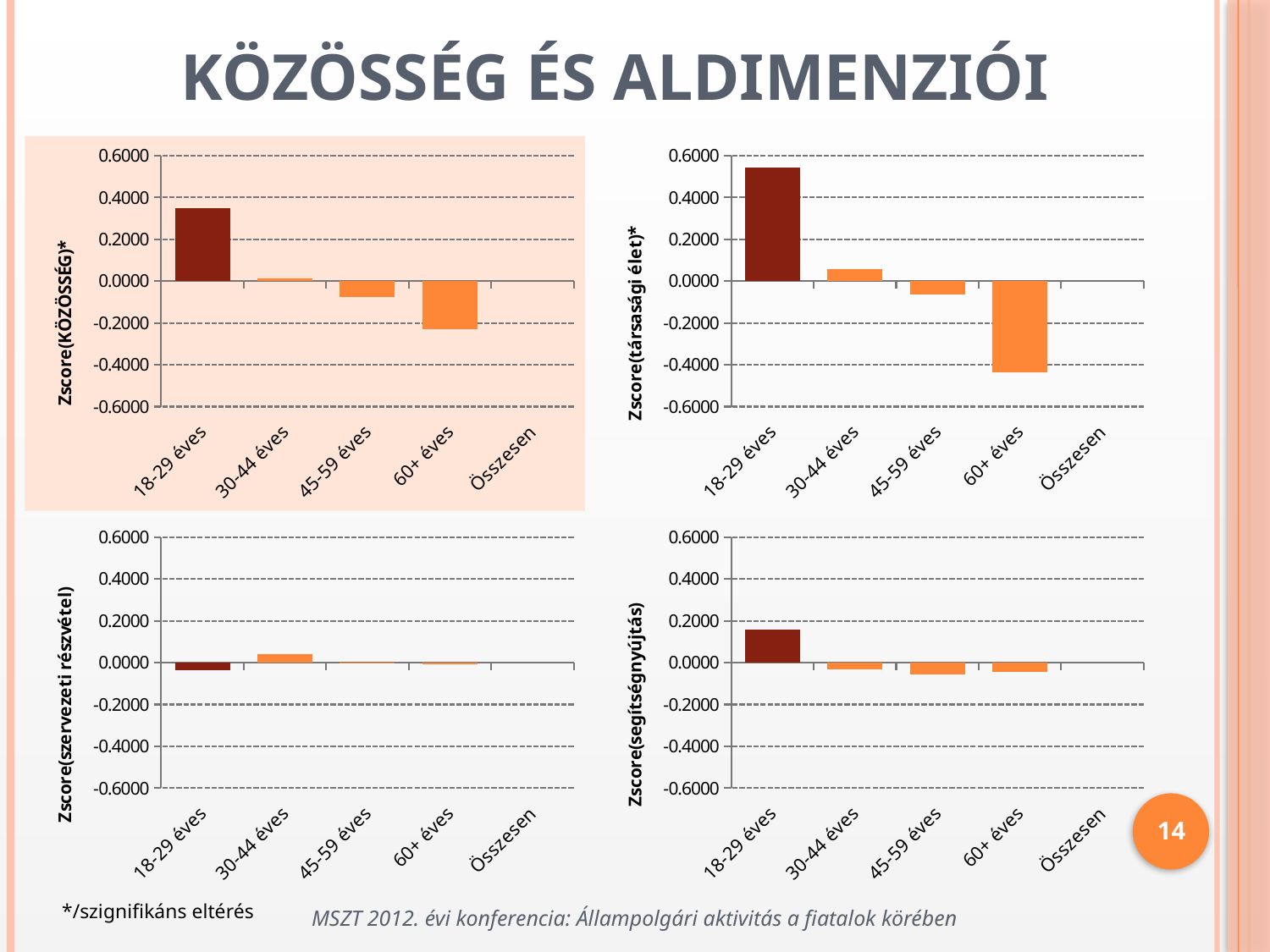
What is the y-axis label of the bottom-left chart? Zscore(szervezeti részvétel) In the top-right chart (Zscore(társasági élet)*), is the value for 18-29 éves greater or less than 0.4000? greater In the top-left chart (Zscore(KÖZÖSSÉG)*), which age group has the lowest value? 60+ éves In the bottom-left chart (Zscore(szervezeti részvétel)), which age group has the highest value? 30-44 éves In the top-right chart (Zscore(társasági élet)*), which age group has the highest value? 18-29 éves In the top-left chart (Zscore(KÖZÖSSÉG)*), which age group has the highest value? 18-29 éves In the top-right chart (Zscore(társasági élet)*), is the value for 60+ éves greater or less than -0.4000? less In the top-left chart (Zscore(KÖZÖSSÉG)*), is the value for 18-29 éves greater or less than 0.2000? greater How many categories are shown on the x axis of the top-right chart (Zscore(társasági élet)*)? 5 What kind of chart is the top-left chart (Zscore(KÖZÖSSÉG)*)? bar chart